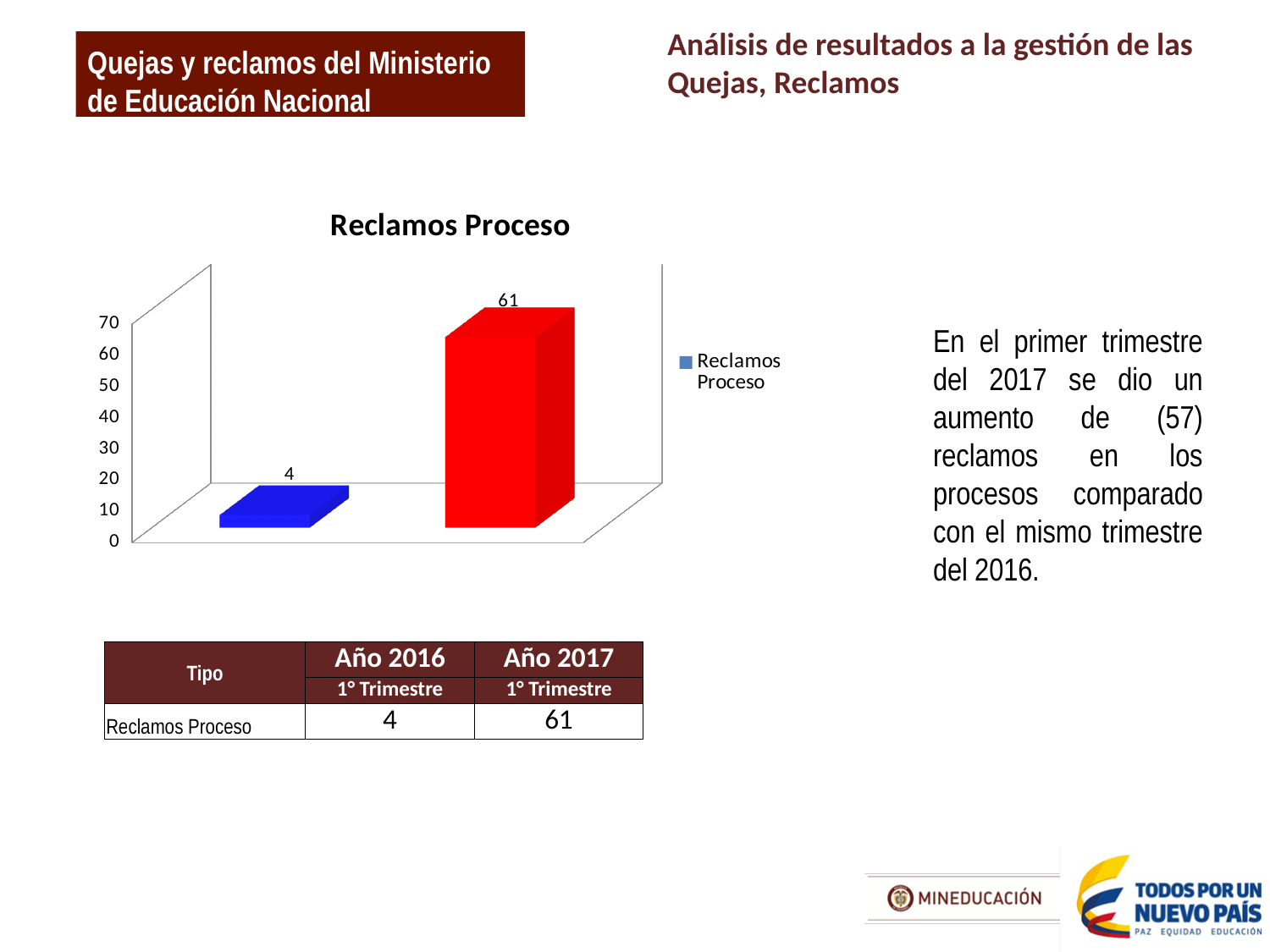
In the "Reclamos Proceso" chart, what value is labelled on the red bar? 61 In the "Reclamos Proceso" chart, what is the difference between the red bar's value and the blue bar's value? 57 In the "Reclamos Proceso" chart, which bar is taller, the blue one or the red one? the red one In the "Reclamos Proceso" chart, is the value of the red bar greater or less than 50? greater In the "Reclamos Proceso" chart, what is the value of the right-hand bar? 61 What is the highest value shown on the vertical axis of the "Reclamos Proceso" chart? 70 What type of chart is shown under the title "Reclamos Proceso"? bar chart In the "Reclamos Proceso" chart, is the value of the blue bar greater or less than 10? less How many bars are plotted in the "Reclamos Proceso" chart? 2 In the "Reclamos Proceso" chart, what is the value of the left-hand bar? 4 How many series does the legend of the "Reclamos Proceso" chart list? 1 In the "Reclamos Proceso" chart, what value is labelled on the blue bar? 4